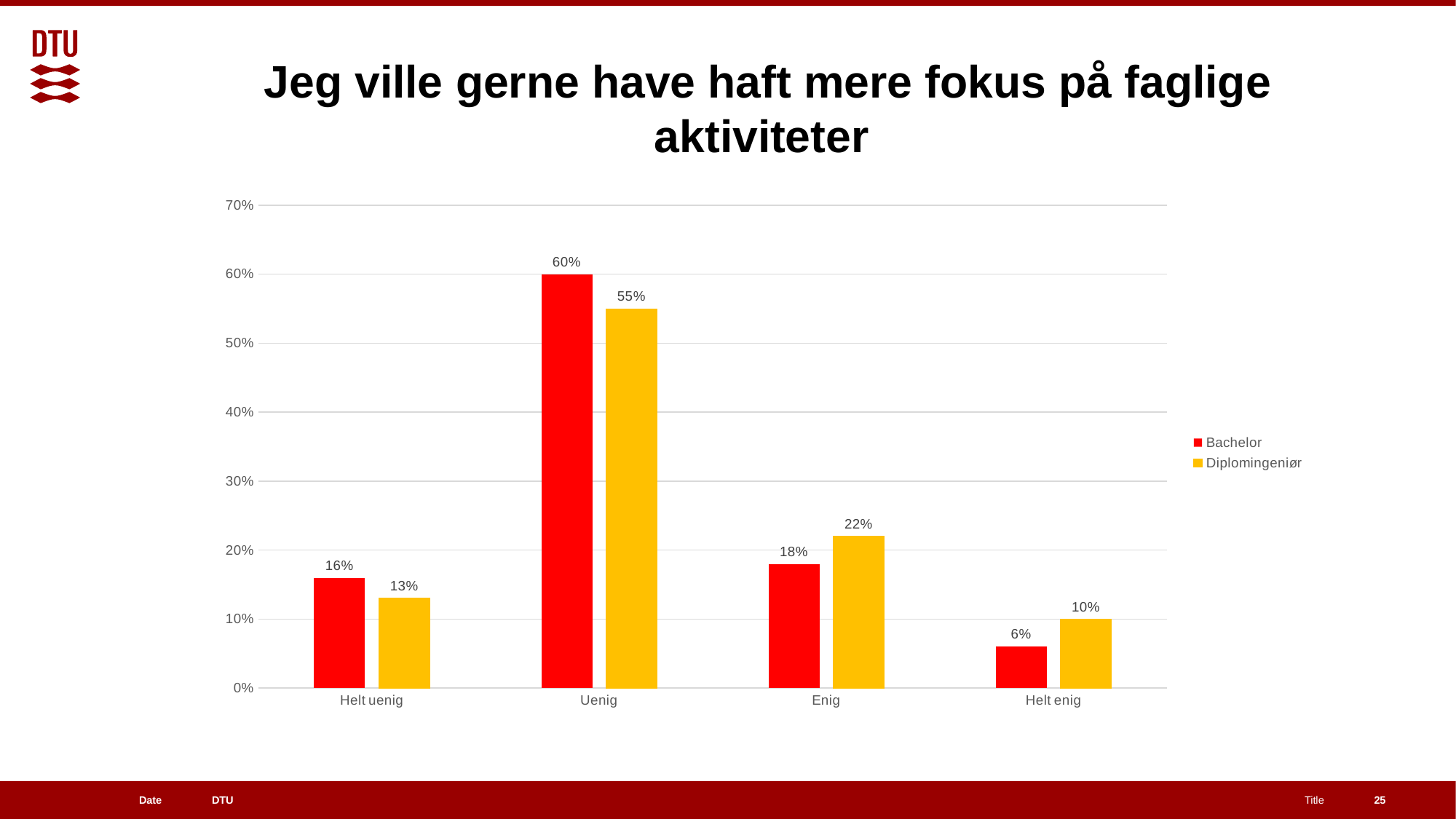
Which colour represents the Diplomingeniør series? Yellow What kind of chart is shown on the slide? Bar chart What is the Bachelor value for Uenig? 60% Is the Diplomingeniør value for Uenig greater or less than 50%? greater What is the Diplomingeniør value for Helt enig? 10% What is the Diplomingeniør value for Enig? 22% How many series does the legend list? 2 Which category has the highest Bachelor value? Uenig How many categories are shown on the x axis? 4 Which is larger for Helt uenig: the Bachelor value or the Diplomingeniør value? Bachelor What is the difference between the Bachelor and Diplomingeniør values for Uenig? 5% Which category has the lowest Diplomingeniør value? Helt enig